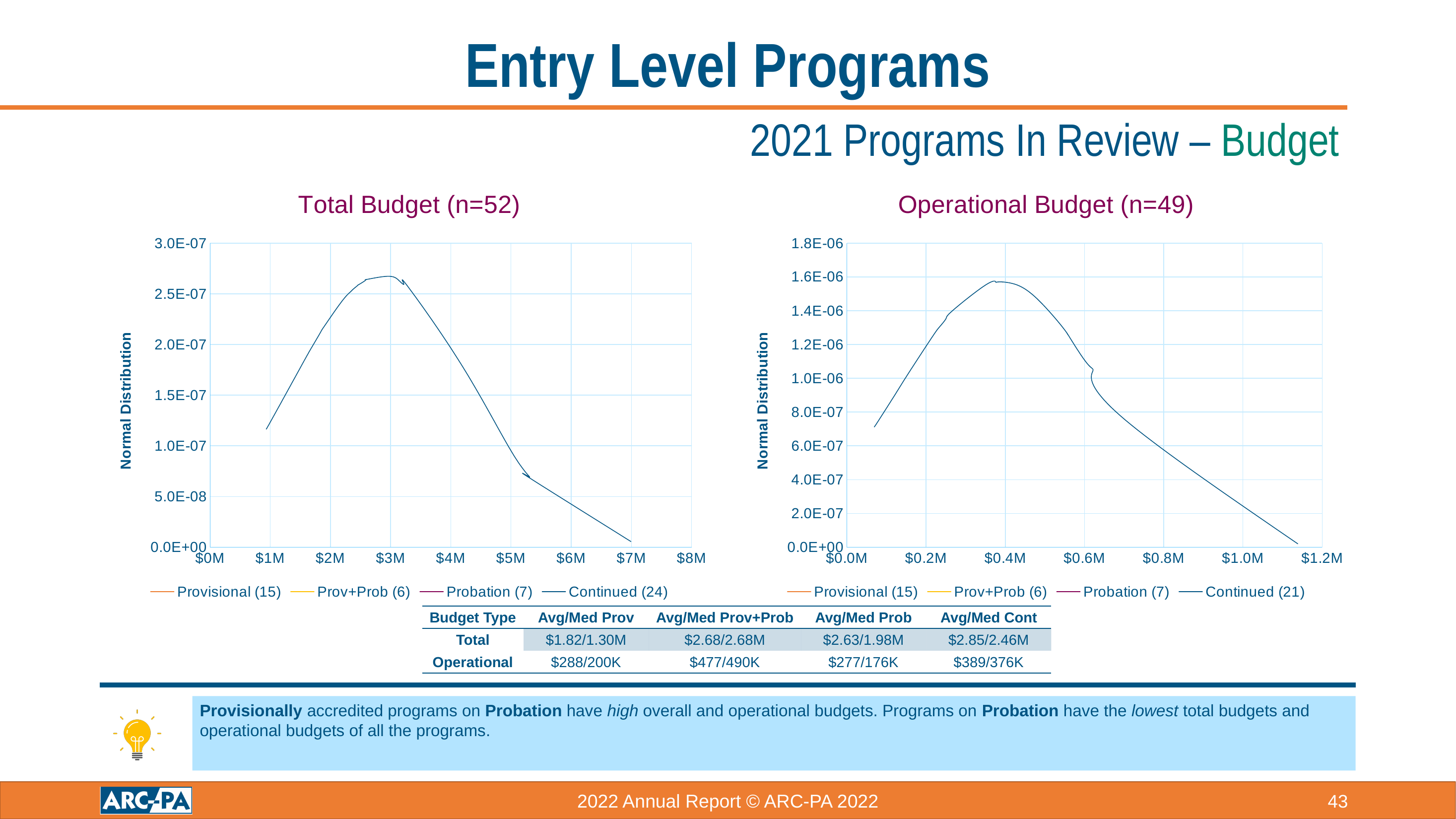
In the Total Budget (n=52) chart, what is the legend label of the last series? Continued (24) What kind of chart is the Total Budget (n=52) chart? line chart In the Operational Budget (n=49) chart, is the value of the line at $1.0M greater or less than 4.0E-07? less In the Operational Budget (n=49) chart, is the peak value of the plotted line greater or less than 1.4E-06? greater In the Operational Budget (n=49) chart, what is the legend label of the last series? Continued (21) In the Total Budget (n=52) chart, does the line rise or fall between $3M and $7M? fall How many series does the legend of the Operational Budget (n=49) chart list? 4 In the Operational Budget (n=49) chart, is the value of the line at $0.2M greater or less than 1.0E-06? greater In the Operational Budget (n=49) chart, does the line rise or fall between $0.0M and $0.4M? rise